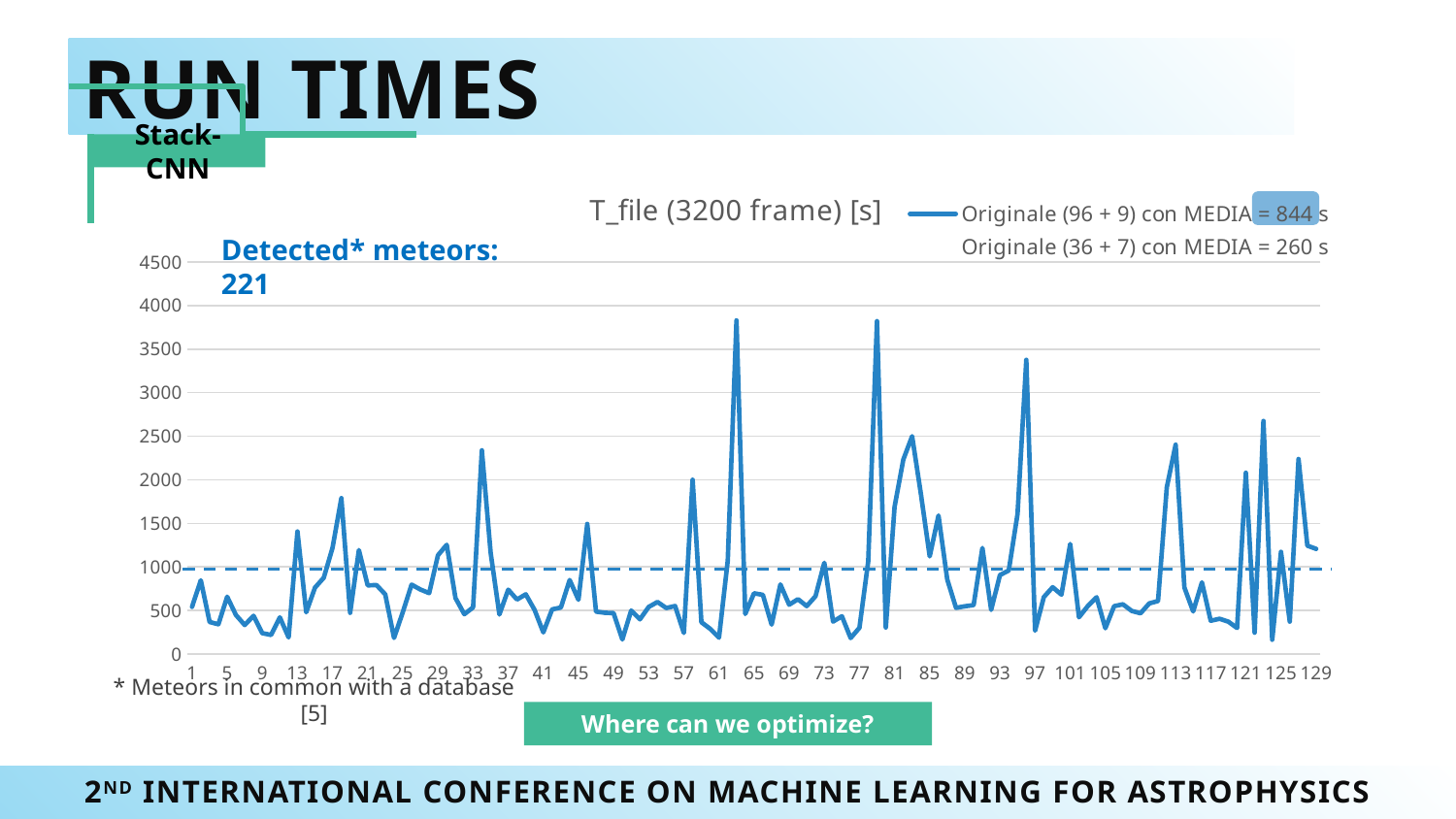
How many series does the chart legend list? 2 What is the title of the chart? T_file (3200 frame) [s] Is the value at x = 17 greater or less than 2000? less Is the value at x = 79 greater or less than 3000? greater Is the value at x = 63 greater or less than 3500? greater What is the highest value shown on the y axis of the chart? 4500 What kind of chart is shown on the slide? line chart What is the first legend entry of the chart? Originale (96 + 9) con MEDIA = 844 s